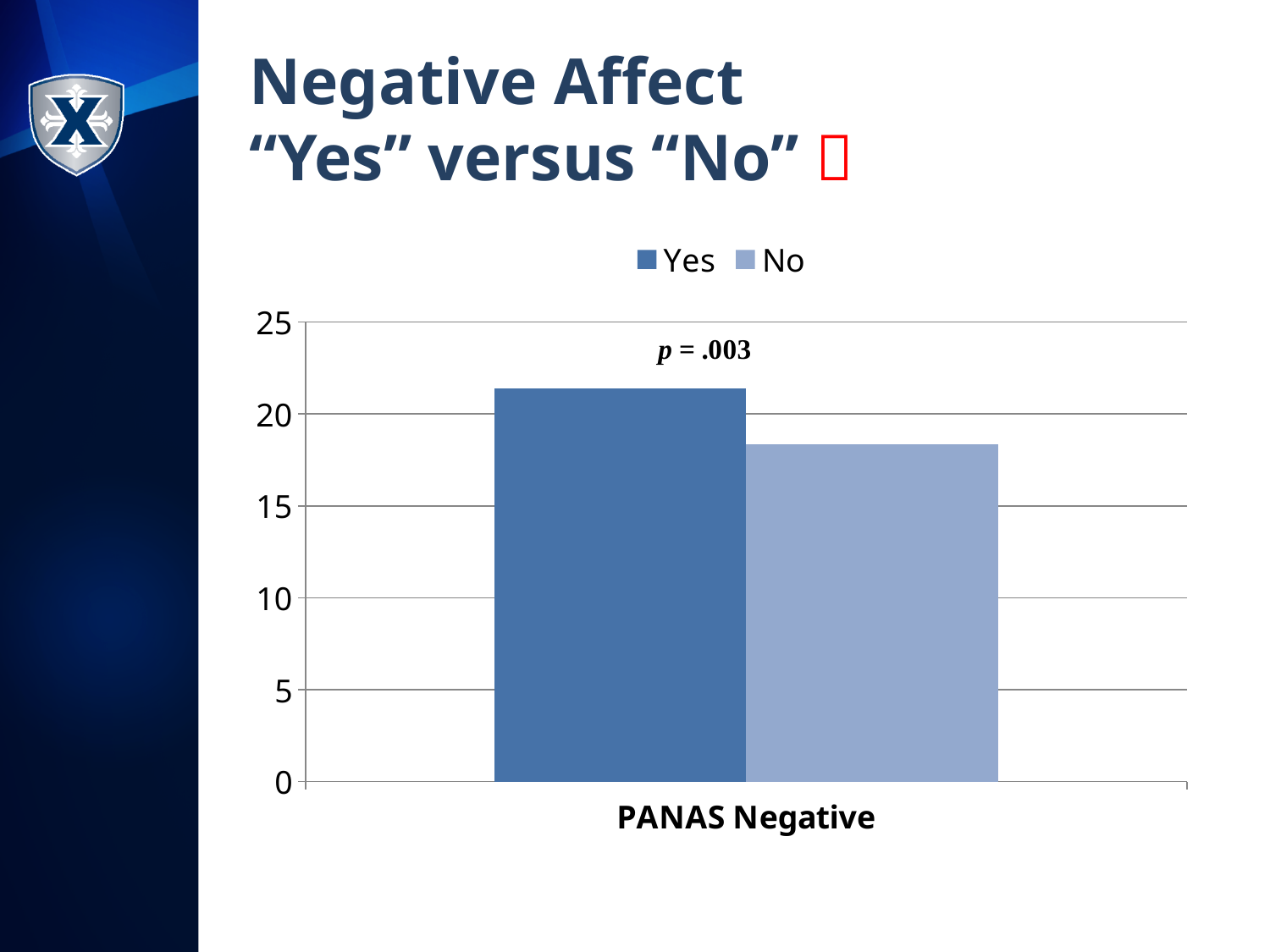
What kind of chart is shown on the slide? bar chart Is the value for Yes on PANAS Negative greater or less than 25? less How many categories are shown on the x axis? 1 What p-value is printed above the bars in the chart? p = .003 Is the value for No on PANAS Negative greater or less than 20? less How many series does the legend list? 2 What are the two entries in the chart legend? Yes, No Which series has the lowest value for PANAS Negative? No Is the value for Yes on PANAS Negative greater or less than 20? greater Which series has the taller bar for PANAS Negative, Yes or No? Yes